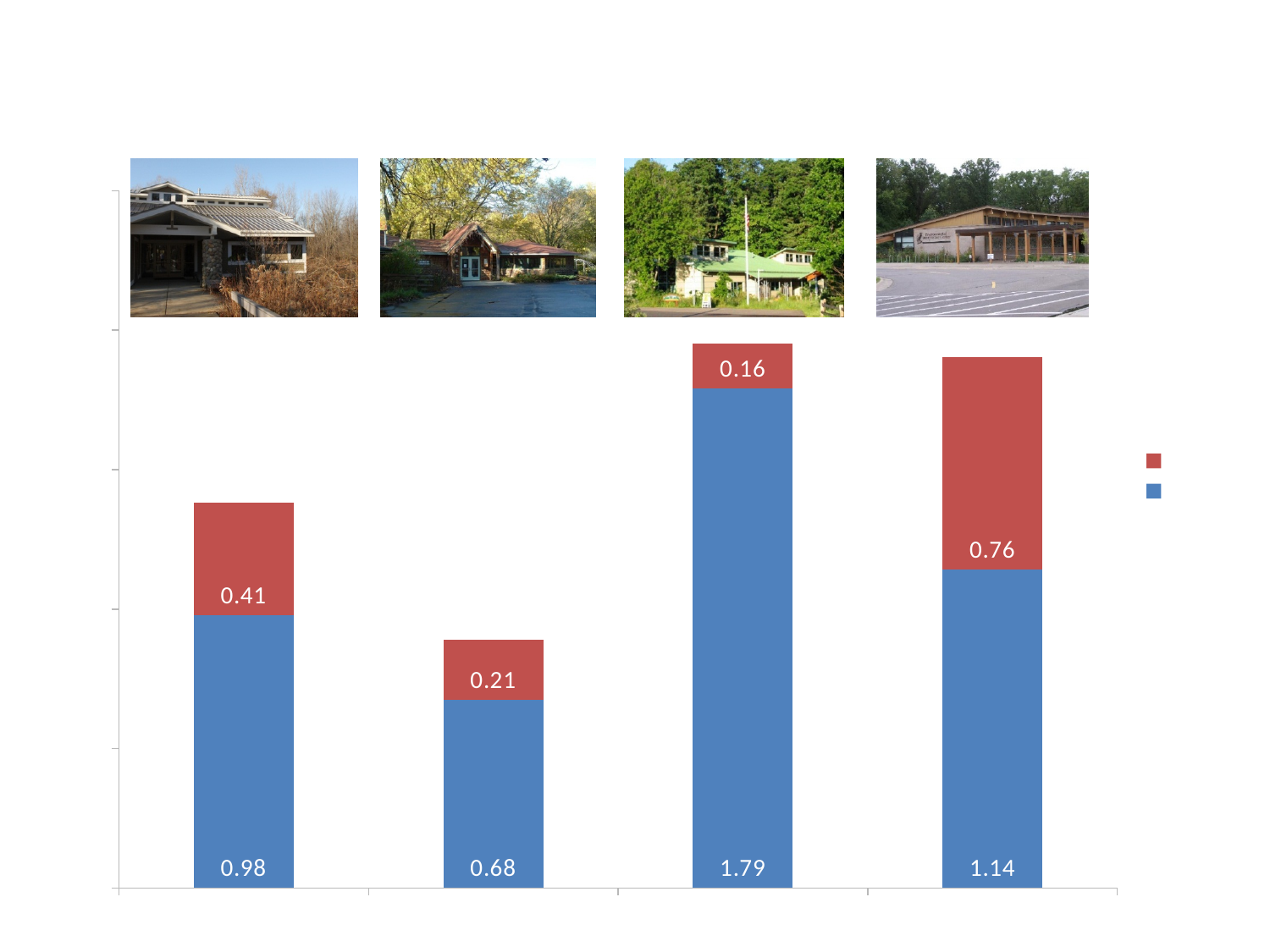
How many bars are plotted in the chart? 4 What is the total of the first bar from the left (blue plus red)? 1.39 Which bar has the smallest red segment? The third bar from the left (0.16) What is the value of the red segment of the second bar from the left? 0.21 What is the value of the blue segment of the first bar from the left? 0.98 Which is larger: the red segment of the fourth bar or the red segment of the first bar? The fourth bar (0.76) Which bar has the largest blue segment? The third bar from the left (1.79) What is the total of the fourth bar from the left (blue plus red)? 1.90 What is the difference between the blue segments of the third and second bars from the left? 1.11 What type of chart is shown on the slide? Stacked bar chart How many series does the legend list? 2 What is the value of the red segment of the third bar from the left? 0.16